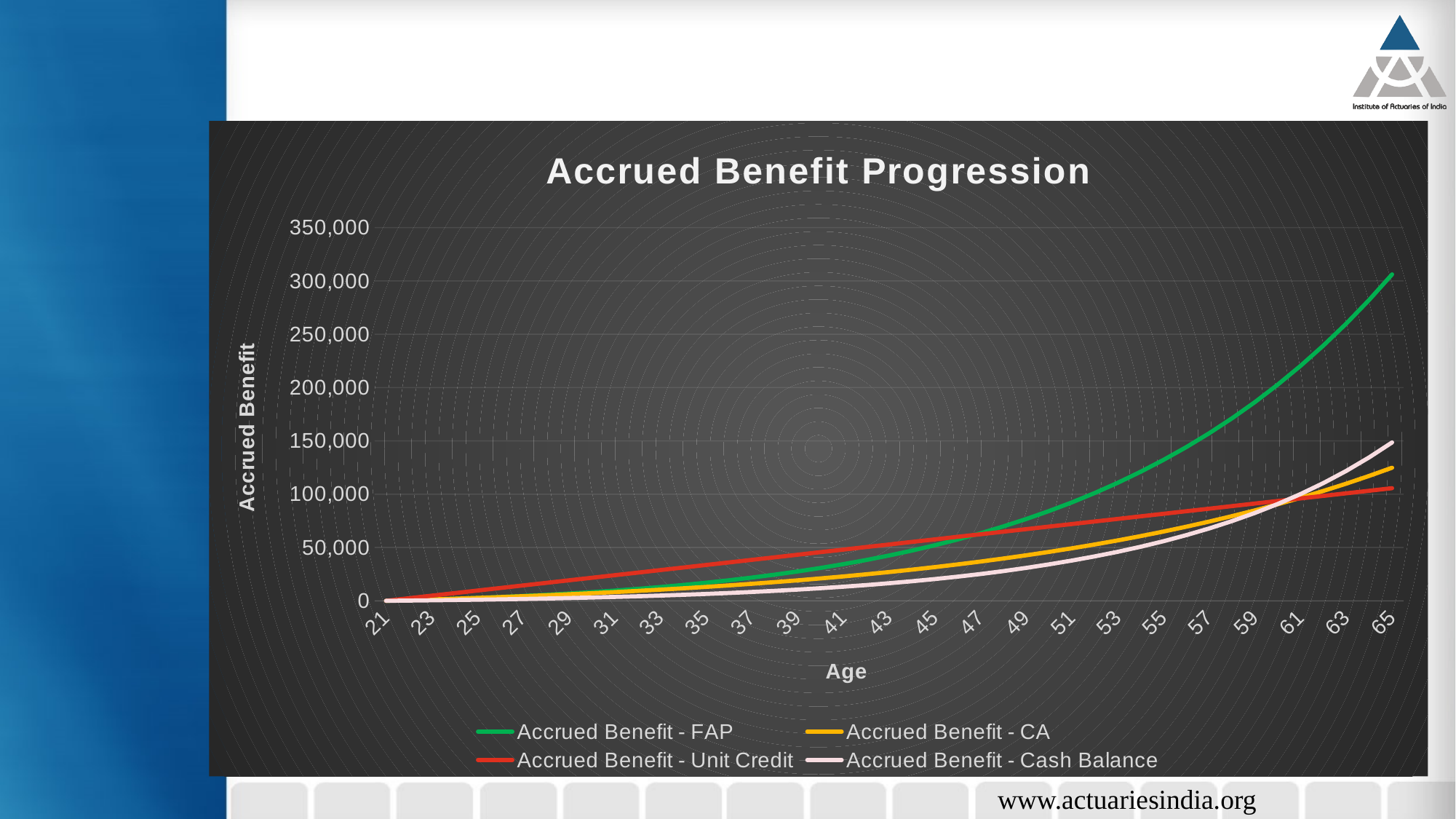
How many series does the legend list? 4 Which series has the lowest accrued benefit at age 65? Accrued Benefit - Unit Credit Which series has the lowest accrued benefit at age 41? Accrued Benefit - Cash Balance Is the value for Accrued Benefit - FAP at age 65 greater or less than 250,000? greater Does the Accrued Benefit - FAP line rise or fall as age increases from 21 to 65? rise Which series has the highest accrued benefit at age 65? Accrued Benefit - FAP What is the title of the chart? Accrued Benefit Progression Which series has the highest accrued benefit at age 41? Accrued Benefit - Unit Credit What kind of chart is shown on the slide? line chart At age 65, which is larger: Accrued Benefit - Cash Balance or Accrued Benefit - CA? Accrued Benefit - Cash Balance What is the label of the vertical axis? Accrued Benefit Is the value for Accrued Benefit - Unit Credit at age 65 greater or less than 150,000? less